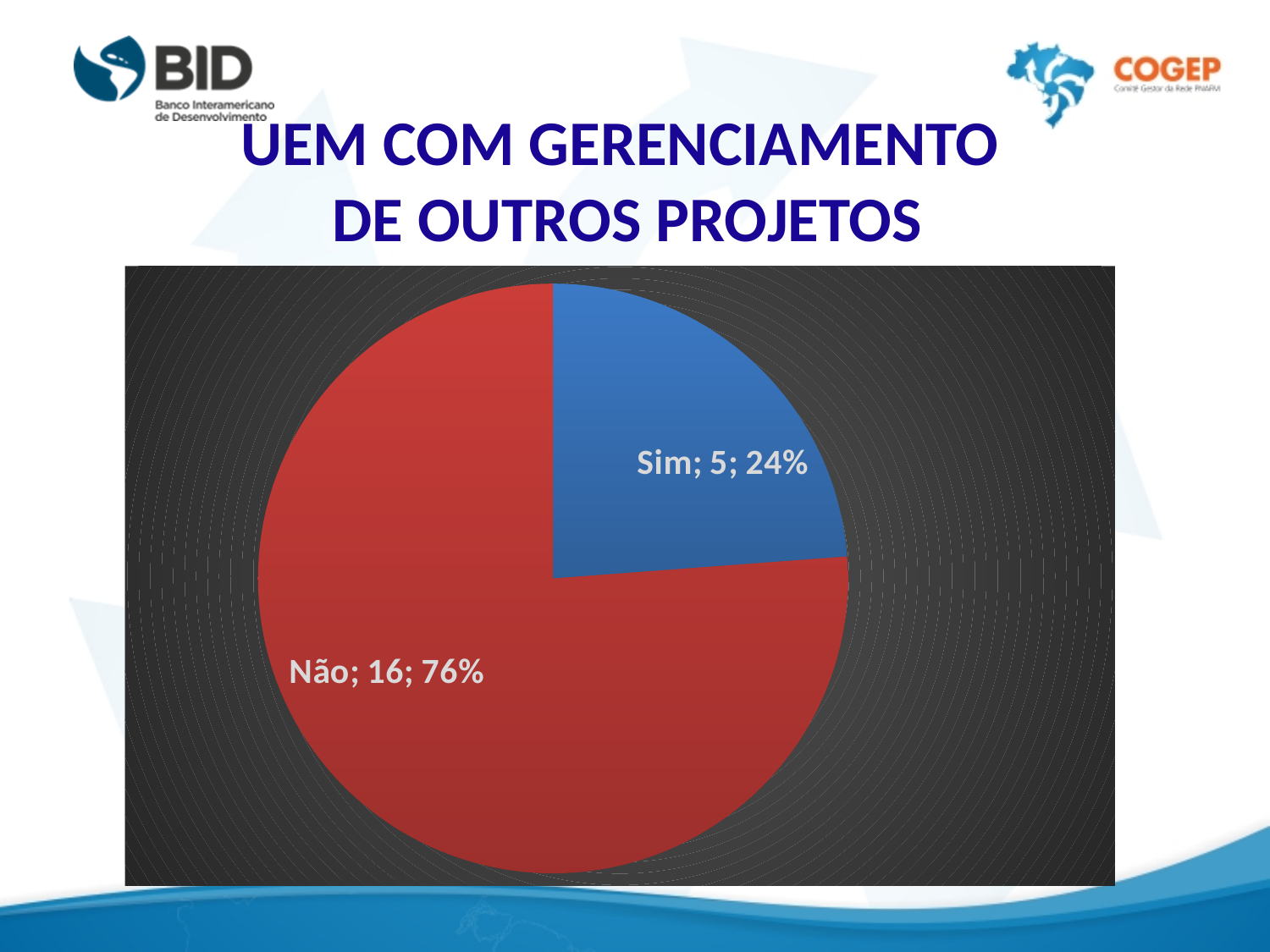
What is the difference in count between "Não" and "Sim"? 11 What kind of chart is shown on the slide? Pie chart What percentage share does the "Não" slice represent? 76% What is the count for the "Não" slice? 16 What colour is the "Não" slice? Red What percentage share does the "Sim" slice represent? 24% Which is larger, the "Sim" slice or the "Não" slice? Não Which slice is the largest? Não What is the total count across both slices? 21 How many slices does the pie chart have? 2 What is the count for the "Sim" slice? 5 Which slice is the smallest? Sim